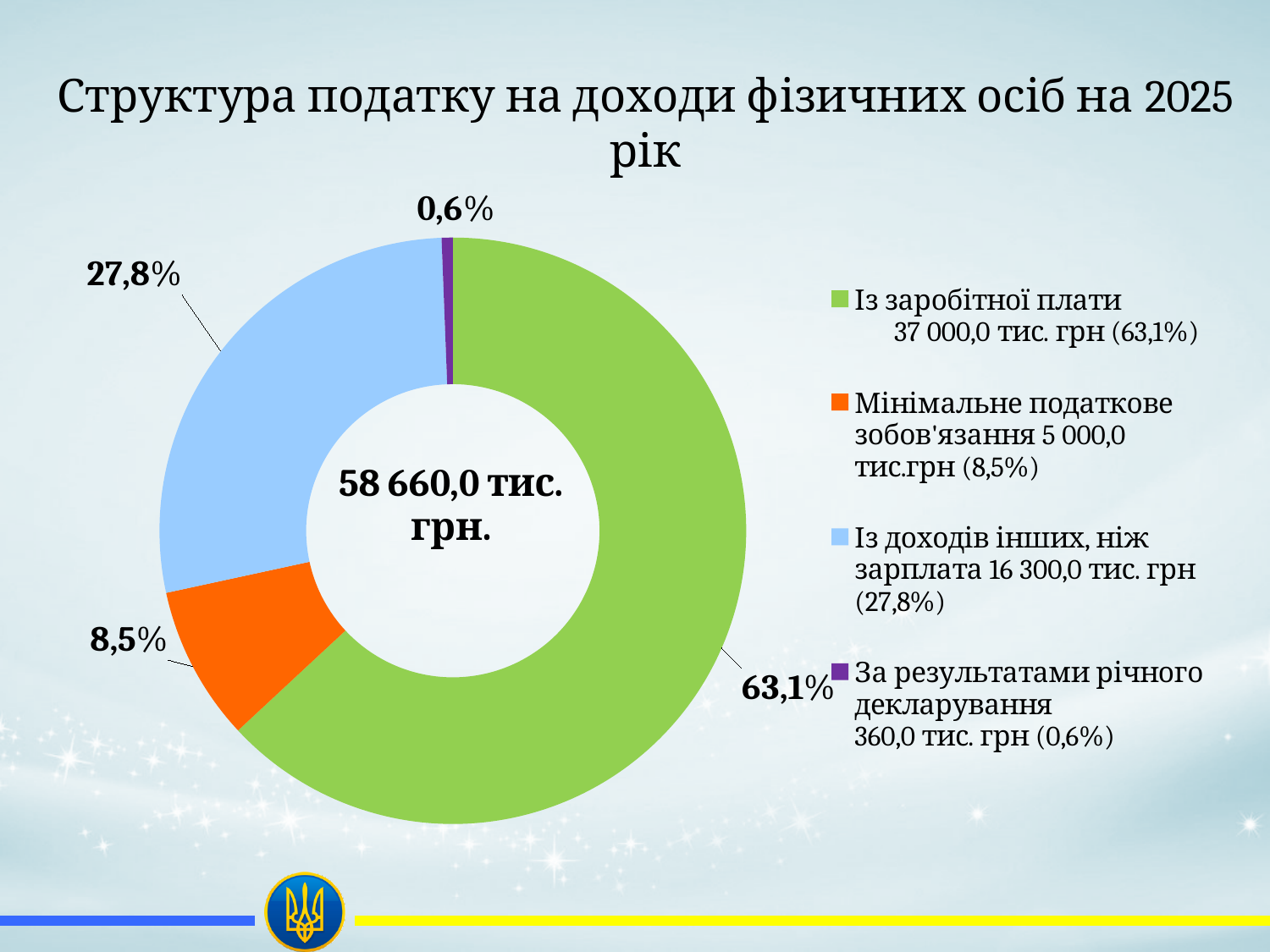
Which is larger: the slice for "Мінімальне податкове зобов'язання" or the slice for "Із доходів інших, ніж зарплата"? Із доходів інших, ніж зарплата What is the difference in percentage points between the "Із заробітної плати" slice and the "Із доходів інших, ніж зарплата" slice? 35,3 How many slices does the chart have? 4 What percentage is shown for "Мінімальне податкове зобов'язання"? 8,5% How many entries does the legend list? 4 What kind of chart is shown on the slide? Doughnut (pie) chart Which category has the smallest slice? За результатами річного декларування Which category has the largest slice? Із заробітної плати What percentage is shown for "За результатами річного декларування"? 0,6% What share of the chart is labelled for "Із заробітної плати"? 63,1% What percentage is shown for "Із доходів інших, ніж зарплата"? 27,8% What total amount is printed in the centre of the chart? 58 660,0 тис. грн.